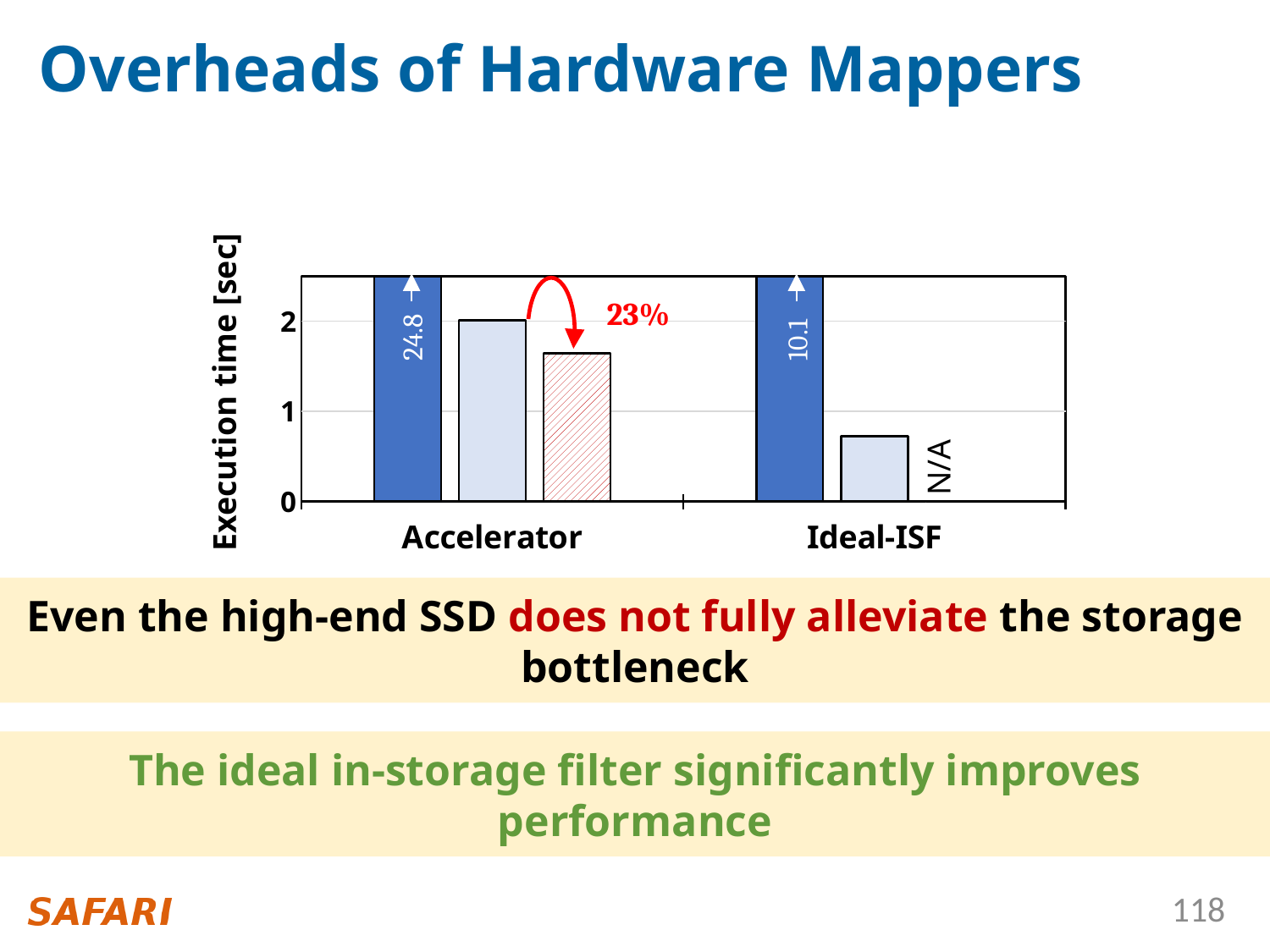
What is the title of the y axis of the chart? Execution time [sec] What is shown in place of the third bar for Ideal-ISF? N/A What percentage is annotated in red above the Accelerator bars? 23% What value is printed on the dark blue bar for Ideal-ISF? 10.1 What kind of chart is shown on the slide? bar chart Is the value of the light blue bar for Ideal-ISF greater or less than 1? less Is the value of the red hatched bar for Accelerator greater or less than 1? greater What value is printed on the dark blue bar for Accelerator? 24.8 Is the value of the light blue bar for Accelerator greater or less than 1? greater Which category has the larger dark blue bar value, Accelerator or Ideal-ISF? Accelerator What is the difference between the dark blue bar values for Accelerator (24.8) and Ideal-ISF (10.1)? 14.7 How many categories are shown on the x axis of the chart? 2